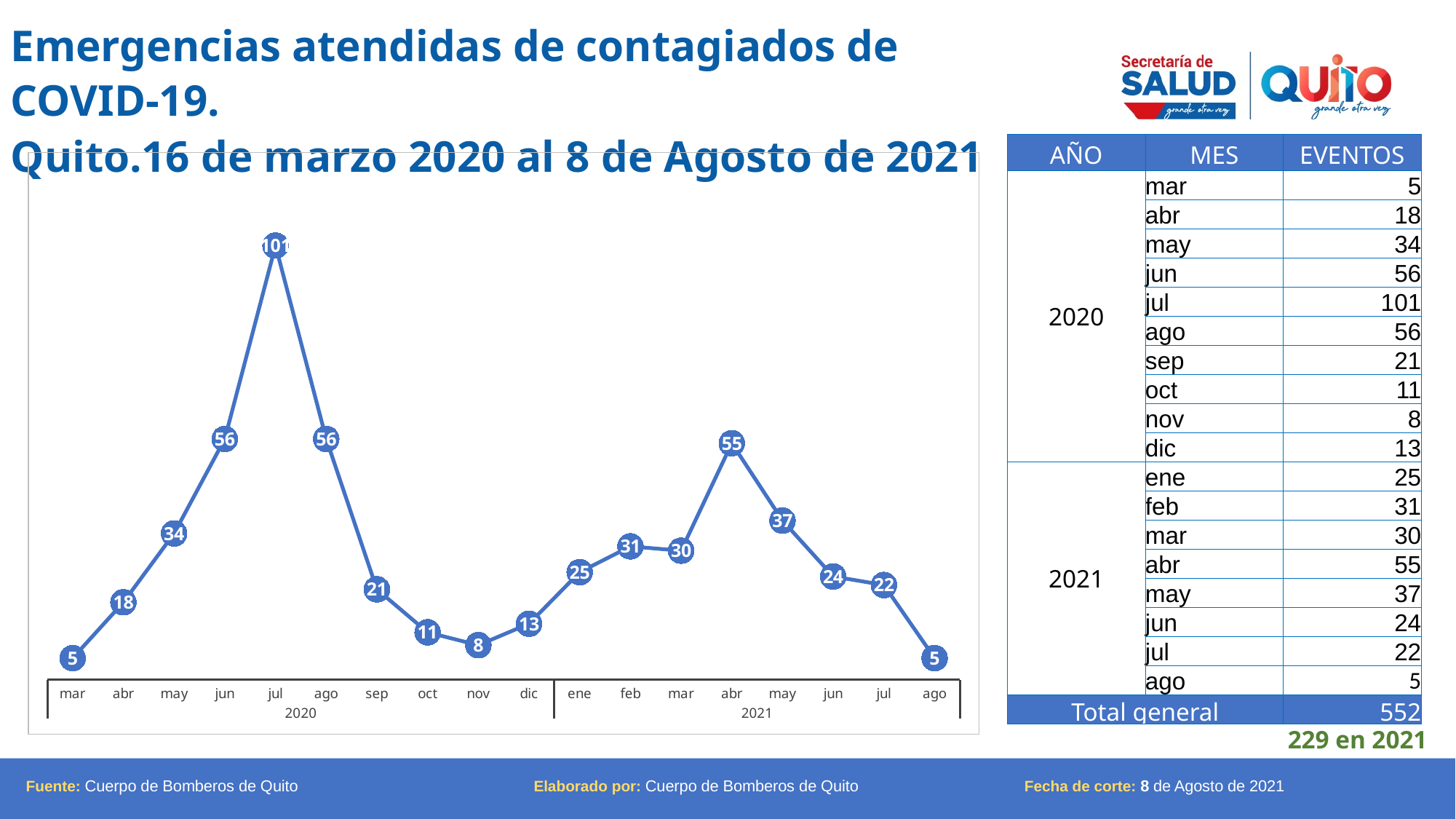
What is the value for nov 2020? 8 What type of chart is shown on the slide? line chart What is the total of all events shown in the table? 552 What is the value for abr 2021? 55 Which month in 2021 has the highest value? abr Which is larger, the value for may 2021 or the value for may 2020? may 2021 Do the values rise or fall from abr 2021 to ago 2021? fall What is the difference between the values for jul 2020 and abr 2021? 46 Which month has the highest value? jul 2020 How many data points are plotted on the line? 18 What is the value for jul 2020? 101 What is the difference between the values for jun 2020 and sep 2020? 35